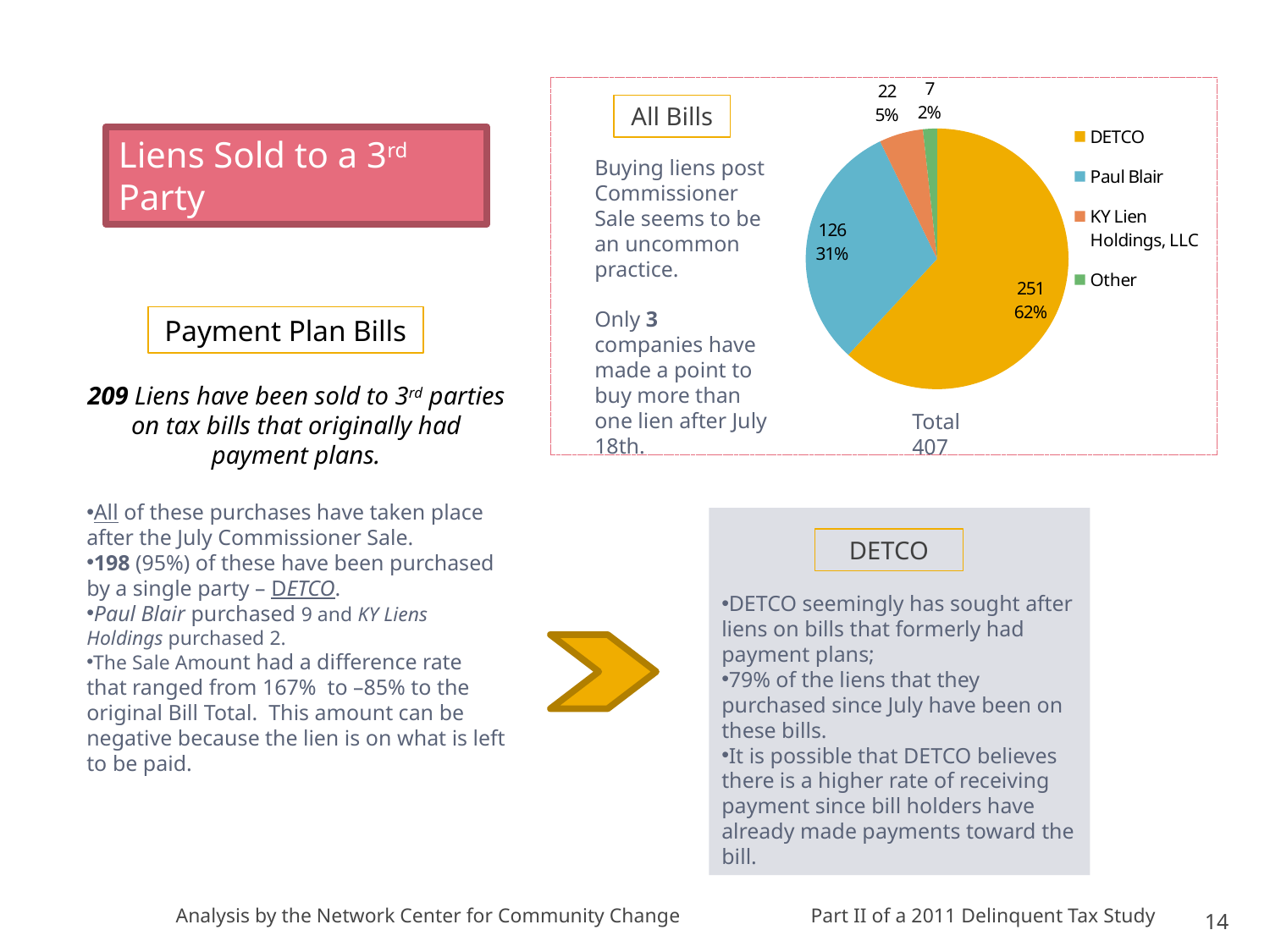
What is the difference between the DETCO value and the Paul Blair value in the pie chart? 125 What colour is the DETCO slice in the pie chart? yellow Which category has the largest slice of the pie chart? DETCO How many categories does the pie chart legend list? 4 What kind of chart is shown on the slide? pie chart What total is printed below the pie chart? 407 What percentage of the pie does Paul Blair account for? 31% Which category has the smallest slice of the pie chart? Other Which is larger in the pie chart, KY Lien Holdings, LLC or Other? KY Lien Holdings, LLC How many liens does the pie chart show for DETCO? 251 What percentage of the pie is labelled for the Other slice? 2% What value is shown for KY Lien Holdings, LLC in the pie chart? 22